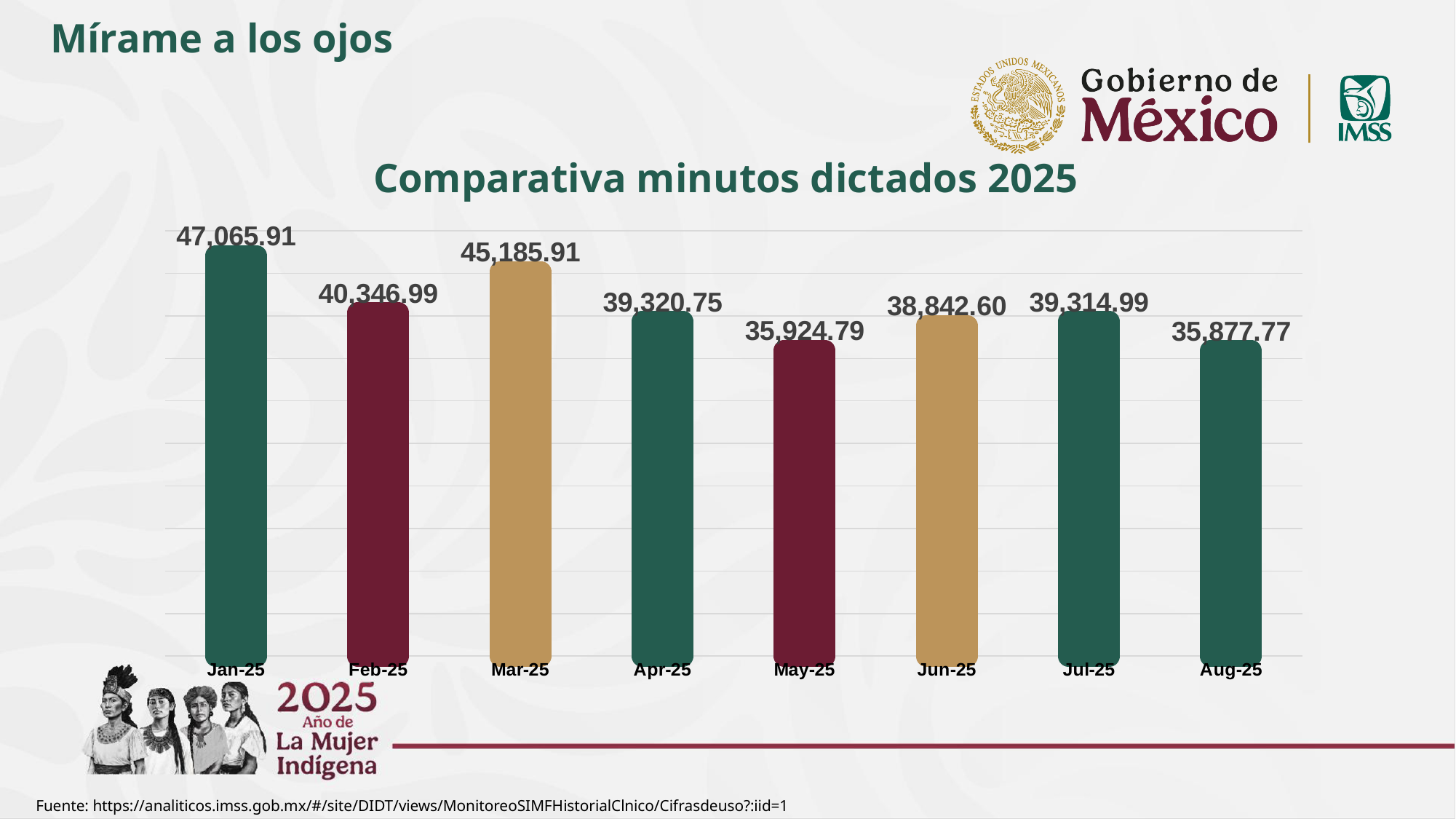
How many months are shown in the chart? 8 What is the value for Jun-25 in the chart? 38,842.60 What is the value for Mar-25 in the chart? 45,185.91 What is the difference between the values for Mar-25 and Apr-25? 5,865.16 Which month has the highest value in the chart? Jan-25 What is the title of the chart? Comparativa minutos dictados 2025 Which is larger, the value for Feb-25 or the value for Jun-25? Feb-25 What kind of chart is shown on the slide? Bar chart What is the value for Jan-25 in the chart? 47,065.91 Which month has the lowest value in the chart? Aug-25 What is the value for Aug-25 in the chart? 35,877.77 What is the difference between the values for Jan-25 and Feb-25? 6,718.92